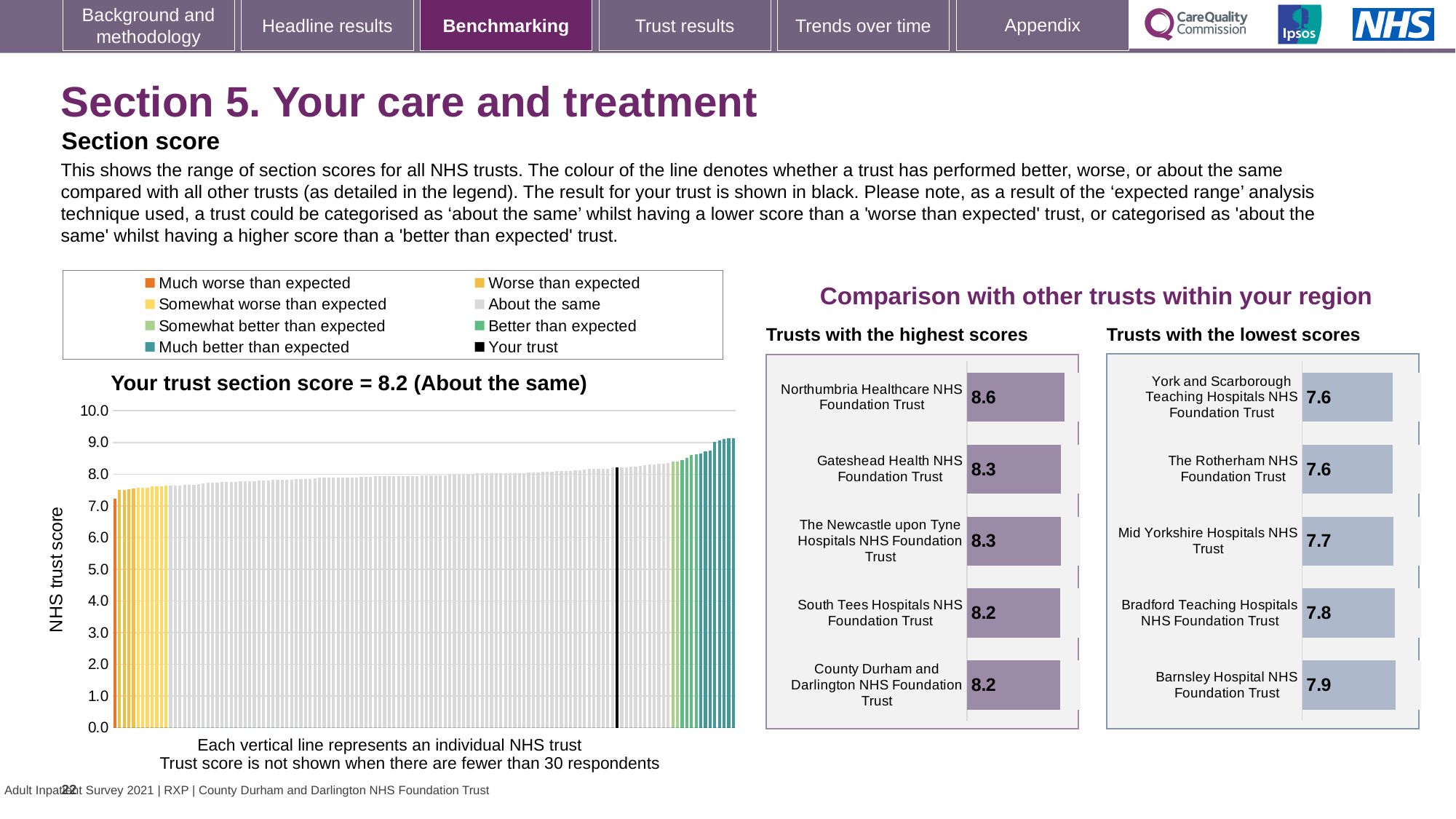
In the 'Trusts with the lowest scores' chart, which has the larger score: Bradford Teaching Hospitals NHS Foundation Trust or Mid Yorkshire Hospitals NHS Trust? Bradford Teaching Hospitals NHS Foundation Trust In the 'Trusts with the highest scores' chart, what is the difference between the scores of Northumbria Healthcare NHS Foundation Trust and Gateshead Health NHS Foundation Trust? 0.3 In the 'Trusts with the lowest scores' chart, what is the difference between the scores of Barnsley Hospital NHS Foundation Trust and York and Scarborough Teaching Hospitals NHS Foundation Trust? 0.3 In the 'Trusts with the highest scores' chart, what is the score for Northumbria Healthcare NHS Foundation Trust? 8.6 In the large chart on the left, what is the section score for your trust? 8.2 In the 'Trusts with the highest scores' chart, which trust has the highest score? Northumbria Healthcare NHS Foundation Trust What kind of chart is the large chart on the left showing NHS trust scores? Bar chart How many trusts are listed in the 'Trusts with the lowest scores' chart? 5 How many trusts are listed in the 'Trusts with the highest scores' chart? 5 In the large chart on the left, is the value of the lowest bar greater or less than 8.0? less In the 'Trusts with the lowest scores' chart, what is the score for Mid Yorkshire Hospitals NHS Trust? 7.7 In the 'Trusts with the lowest scores' chart, which trust has the highest score shown? Barnsley Hospital NHS Foundation Trust